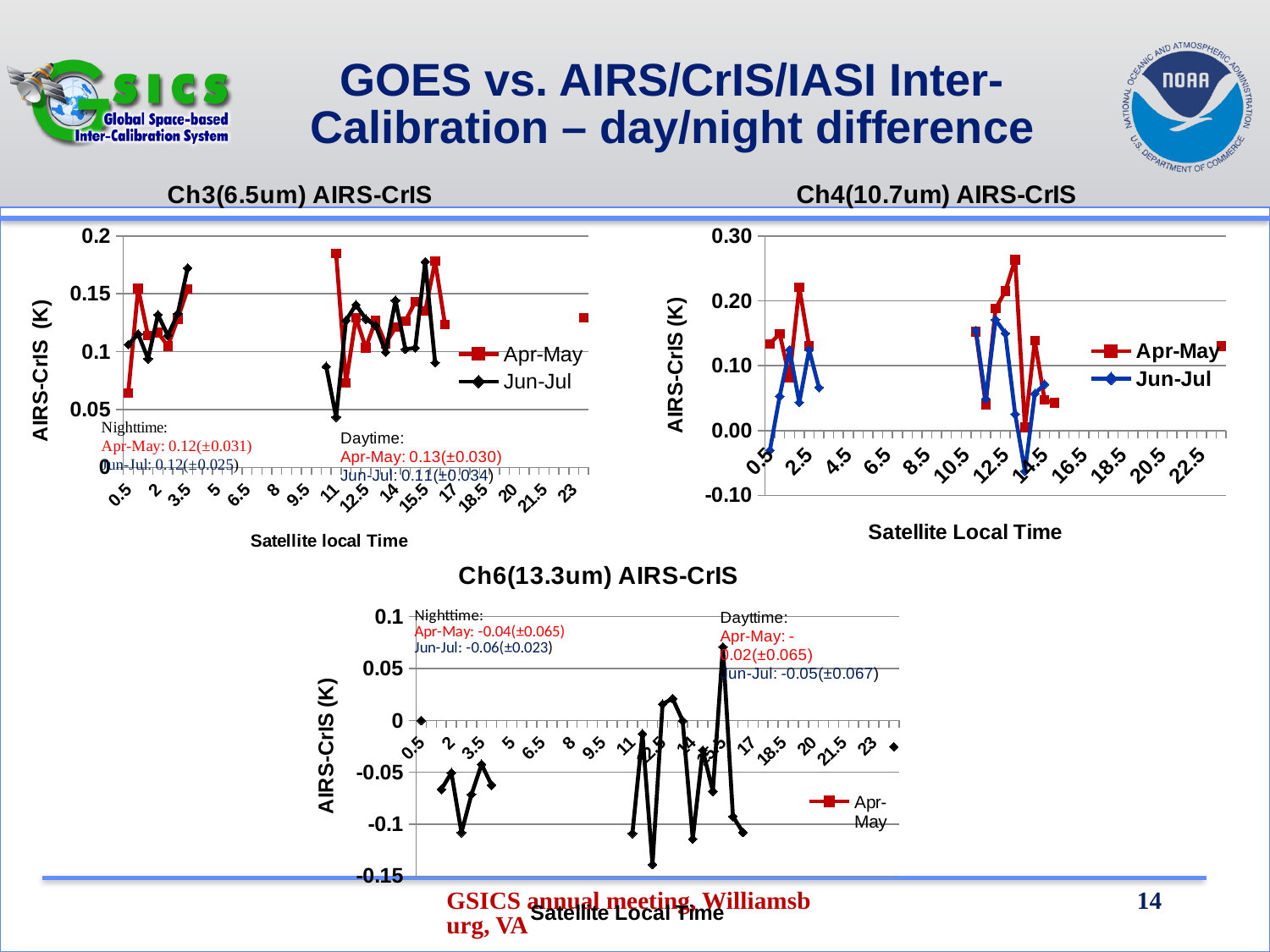
What kind of chart is the Ch3(6.5um) AIRS-CrIS chart? line chart In the Ch6(13.3um) AIRS-CrIS chart, what daytime mean value is given for Jun-Jul? -0.05(±0.067) In the Ch3(6.5um) AIRS-CrIS chart, what daytime mean value is given for Jun-Jul? 0.11(±0.034) In the Ch6(13.3um) AIRS-CrIS chart, is the highest plotted value greater or less than 0.05? greater In the Ch3(6.5um) AIRS-CrIS chart, is the highest Apr-May value greater or less than 0.15? greater In the Ch6(13.3um) AIRS-CrIS chart, is the lowest plotted value greater or less than -0.1? less In the Ch6(13.3um) AIRS-CrIS chart, what nighttime mean value is given for Jun-Jul? -0.06(±0.023) How many series does the legend of the Ch4(10.7um) AIRS-CrIS chart list? 2 What are the two series named in the legend of the Ch3(6.5um) AIRS-CrIS chart? Apr-May and Jun-Jul What is the y-axis label of the Ch4(10.7um) AIRS-CrIS chart? AIRS-CrIS (K) In the Ch3(6.5um) AIRS-CrIS chart, what nighttime mean value is given for Apr-May? 0.12(±0.031)